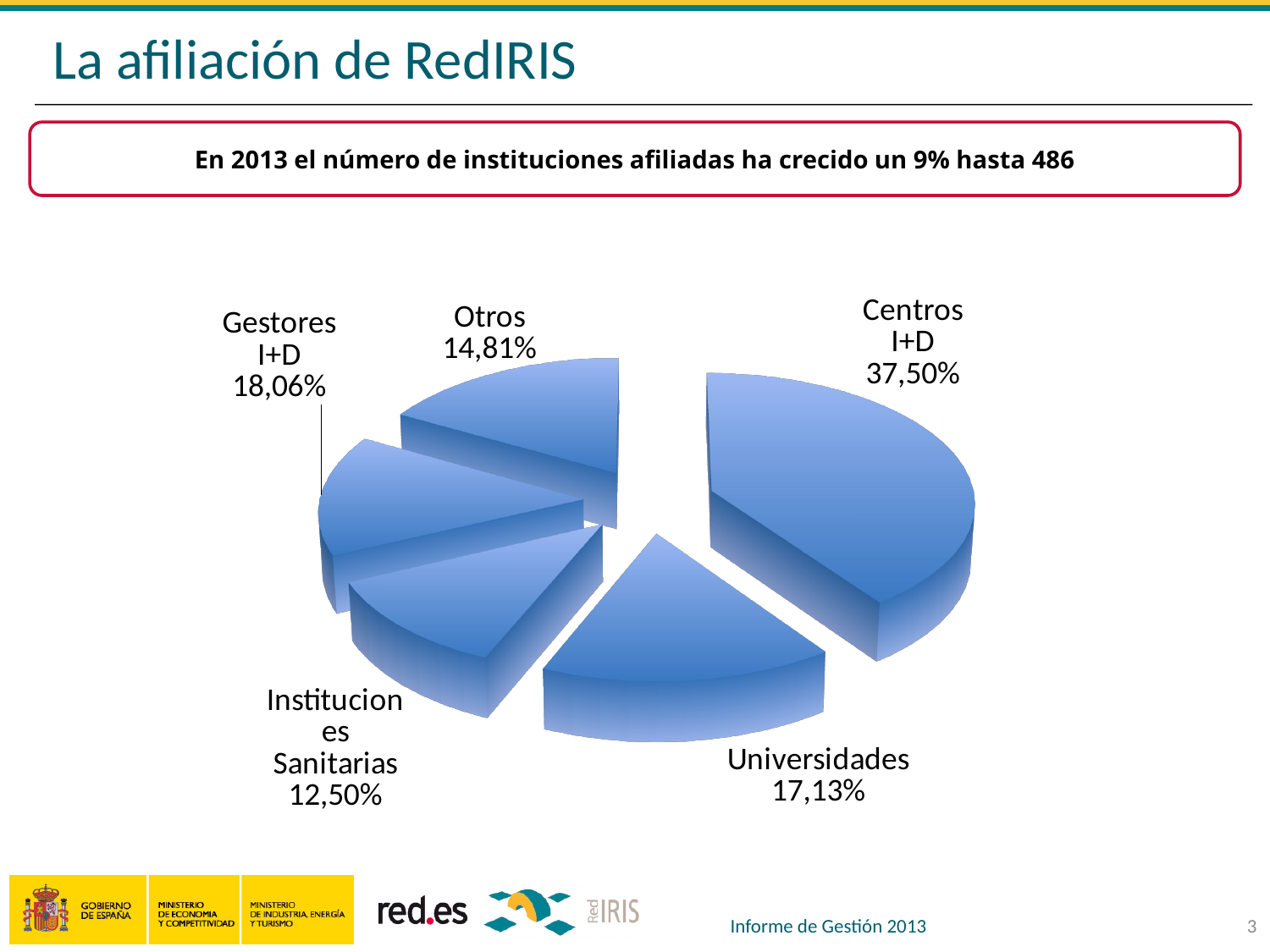
What is the value labelled for Instituciones Sanitarias? 12,50% Which is larger, the share for Gestores I+D or the share for Universidades? Gestores I+D How many categories are shown in the pie chart? 5 Which category has the smallest slice of the pie? Instituciones Sanitarias Which category has the largest slice of the pie? Centros I+D What is the difference in percentage points between Centros I+D and Universidades? 20,37% What percentage is shown for Universidades? 17,13% What share of the pie does Centros I+D represent? 37,50% What kind of chart is shown on the slide? Pie chart What is the title of the slide containing the chart? La afiliación de RedIRIS What percentage is shown for Gestores I+D? 18,06% What is the difference between Gestores I+D and Otros? 3,25%